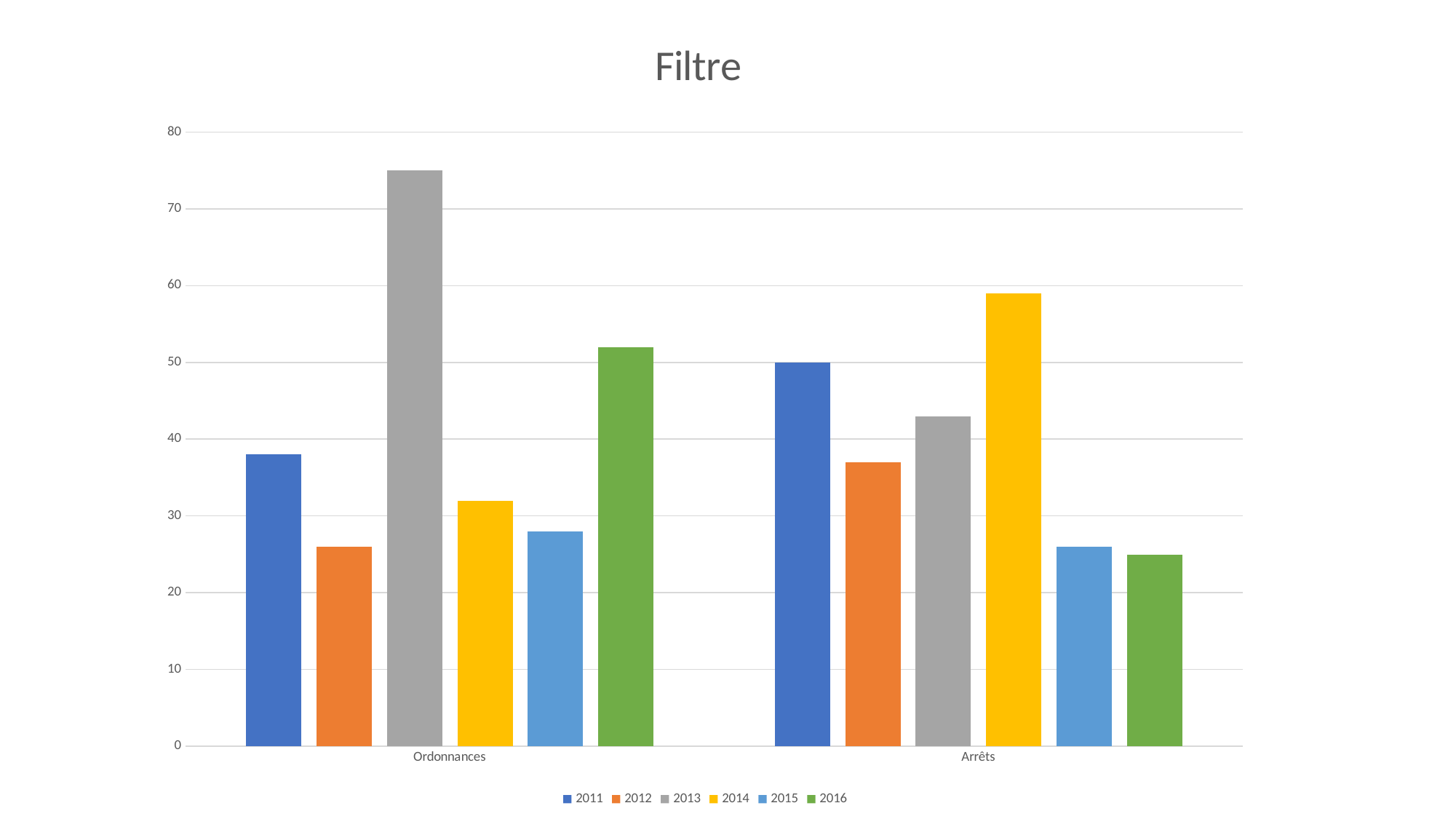
How many categories are shown on the x axis? 2 Is the value for 2012 in Ordonnances greater or less than 30? less Which is larger: the 2013 value for Ordonnances or the 2013 value for Arrêts? Ordonnances How many series does the legend list? 6 Which year has the highest value for Ordonnances? 2013 What kind of chart is shown on the slide? bar chart Is the value for 2016 in Ordonnances greater or less than 50? greater Is the value for 2013 in Ordonnances greater or less than 70? greater Which year has the highest value for Arrêts? 2014 Which is larger: the 2011 value for Ordonnances or the 2011 value for Arrêts? Arrêts What is the title of the chart? Filtre